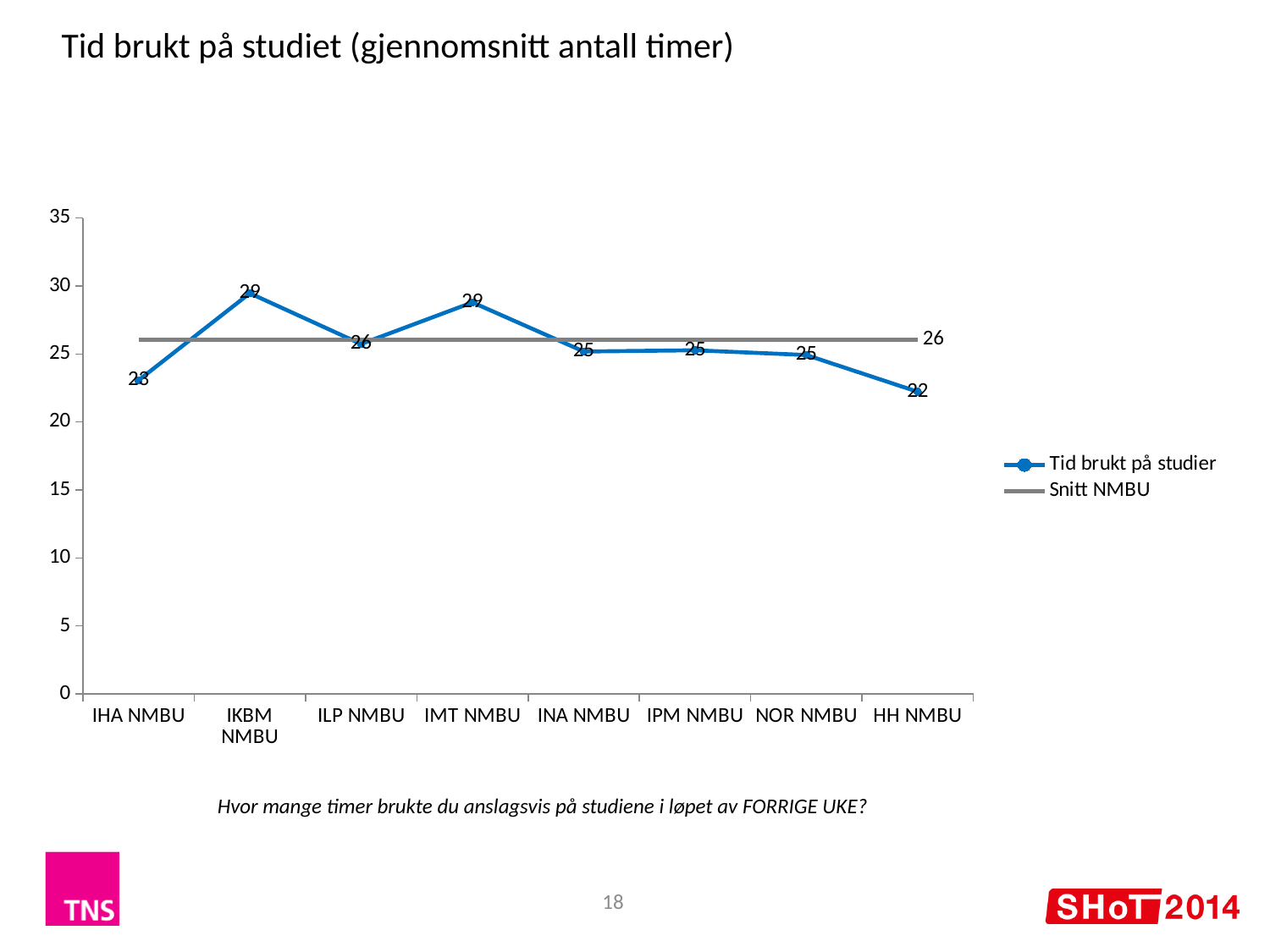
What type of chart is shown on the slide? line chart Which is larger, the value for IMT NMBU or the value for INA NMBU? IMT NMBU How many series does the legend list? 2 What is the value for HH NMBU in the 'Tid brukt på studier' series? 22 What is the highest value shown in the 'Tid brukt på studier' series? 29 What is the title of the chart? Tid brukt på studiet (gjennomsnitt antall timer) What is the difference between the values for IKBM NMBU and IHA NMBU? 6 Which category has the lowest value in the 'Tid brukt på studier' series? HH NMBU How many categories are shown on the x axis? 8 What is the value for IKBM NMBU in the 'Tid brukt på studier' series? 29 What is the value for IHA NMBU in the 'Tid brukt på studier' series? 23 What is the value of the 'Snitt NMBU' line? 26